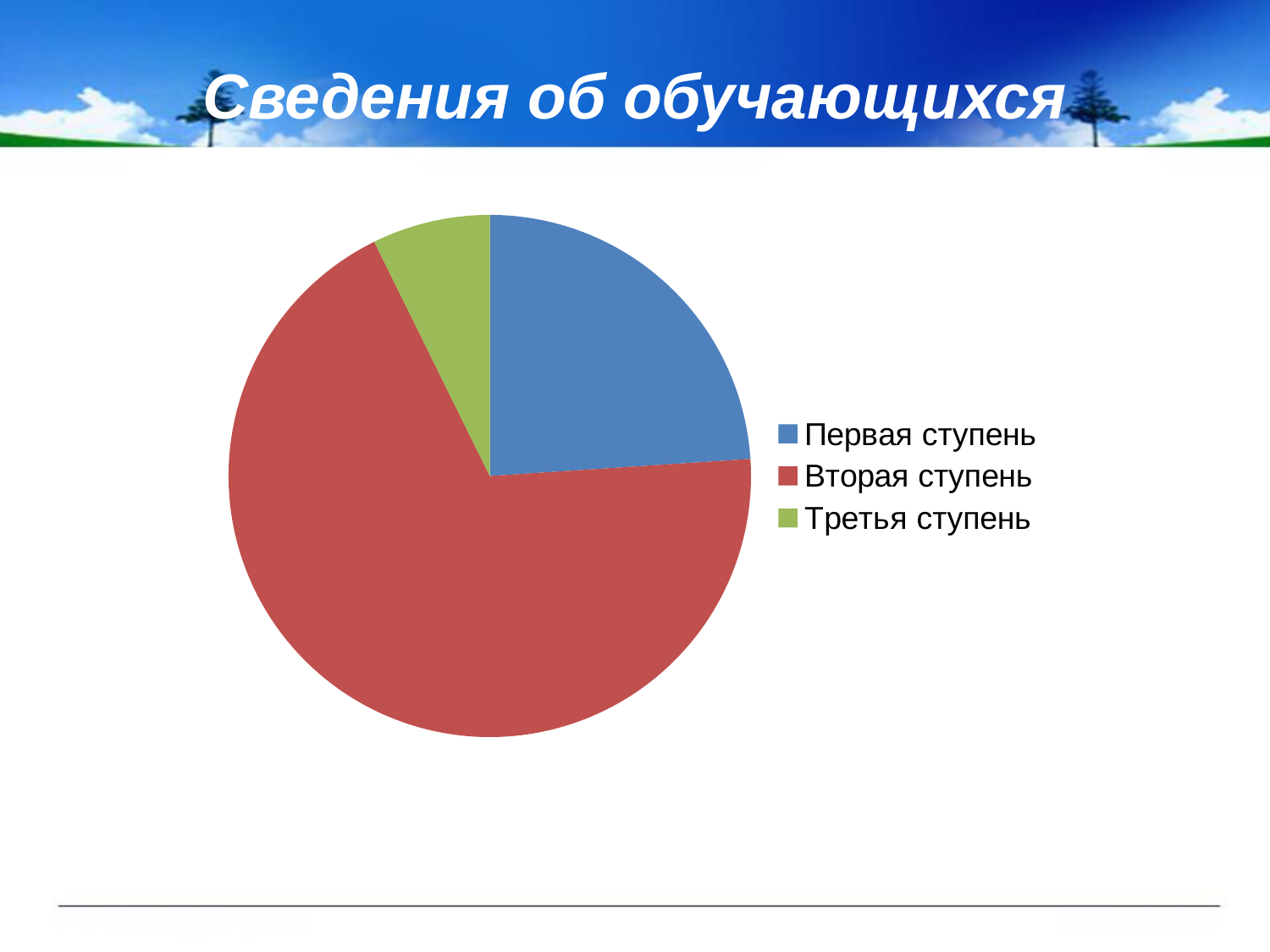
How many entries does the legend list? 3 Which slice is larger, Первая ступень or Третья ступень? Первая ступень What is the title of the slide containing the pie chart? Сведения об обучающихся Which category has the largest slice of the pie? Вторая ступень How many slices does the pie chart have? 3 What colour is the slice for Вторая ступень? red What kind of chart is shown on the slide? pie chart Which slice is larger, Вторая ступень or Первая ступень? Вторая ступень Which category has the smallest slice of the pie? Третья ступень